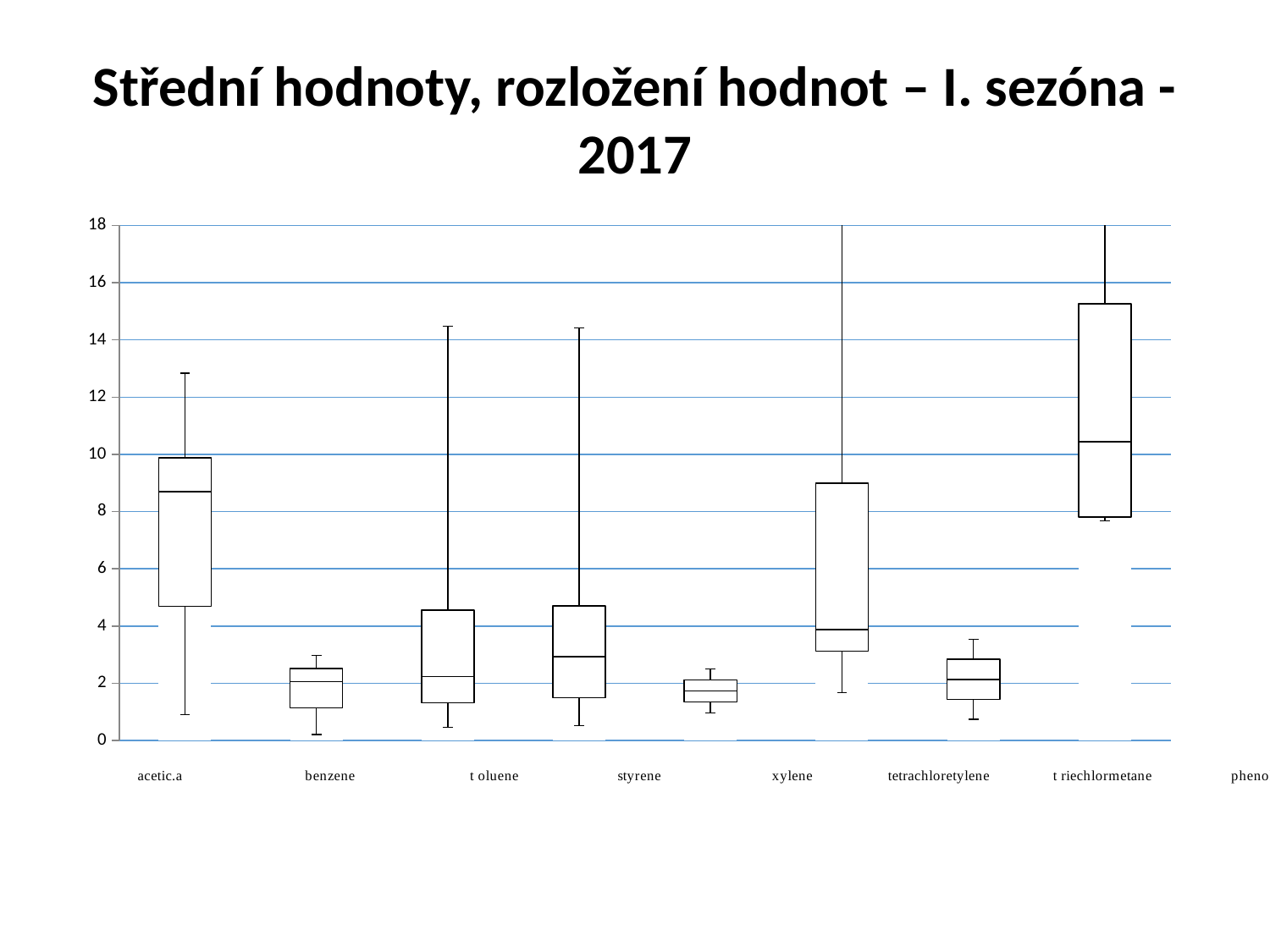
What is the title of the slide? Střední hodnoty, rozložení hodnot – I. sezóna - 2017 Which has the higher median, toluene or benzene? toluene Which has the higher median, acetic.a or xylene? acetic.a What kind of chart is shown on the slide? box plot Is the top of the upper whisker for toluene greater or less than 14? greater Is the median for acetic.a greater or less than 8? greater What is the highest value shown on the vertical axis? 18